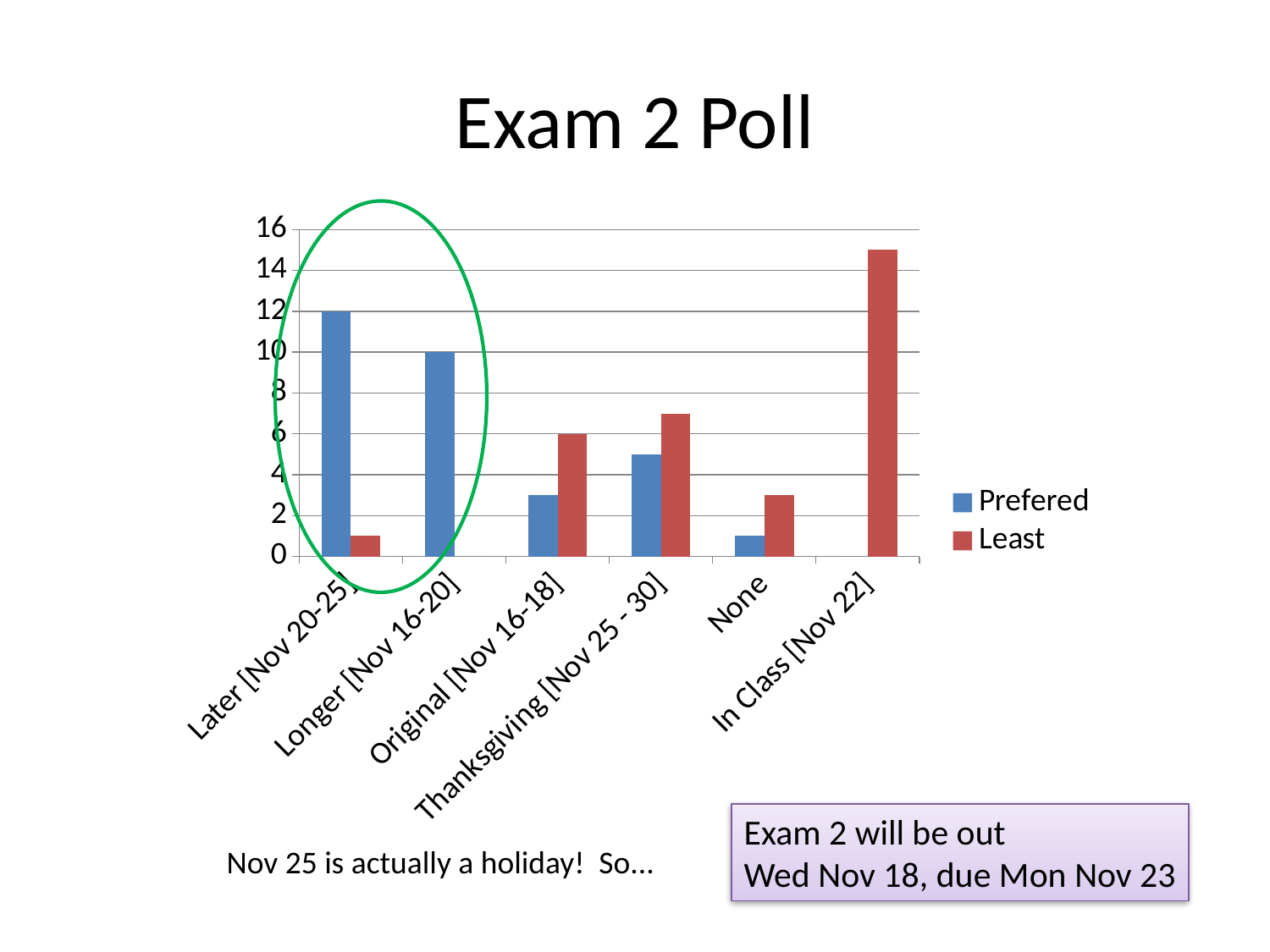
What is the Prefered value for Longer [Nov 16-20]? 10 Which category has the highest Least value? In Class [Nov 22] How many series does the legend list? 2 Is the Prefered value for Original [Nov 16-18] greater or less than 4? less What kind of chart is shown on the slide? Bar chart What is the difference between the Prefered values for Later [Nov 20-25] and Longer [Nov 16-20]? 2 Which is larger: the Least value for Thanksgiving [Nov 25 - 30] or the Least value for None? Thanksgiving [Nov 25 - 30] How many categories are shown on the x axis? 6 Is the Least value for In Class [Nov 22] greater or less than 14? greater Which category has the highest Prefered value? Later [Nov 20-25] What is the Least value for Original [Nov 16-18]? 6 What is the Prefered value for Later [Nov 20-25]? 12